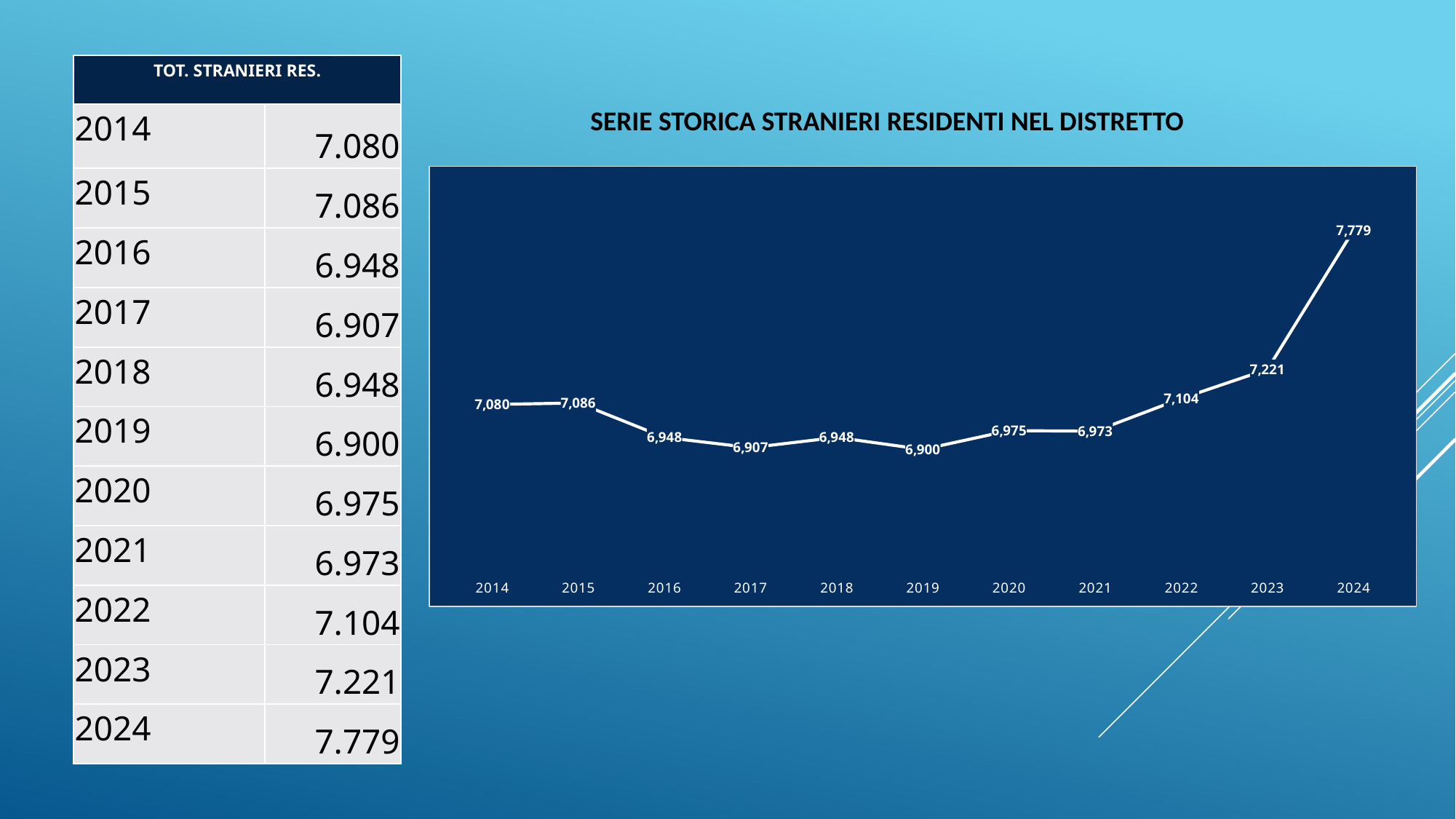
What type of chart is shown on the slide? line chart Which year has the highest value in the chart? 2024 What is the title of the chart? SERIE STORICA STRANIERI RESIDENTI NEL DISTRETTO What is the value for 2014 in the chart? 7,080 Which year has the lowest value in the chart? 2019 Do the values rise or fall from 2021 to 2024? rise What is the value for 2022 in the chart? 7,104 How many years are plotted on the x axis of the chart? 11 What is the difference between the values for 2014 and 2019? 180 What is the difference between the values for 2024 and 2023? 558 Which is larger, the value for 2017 or the value for 2020? 2020 What is the value for 2019 in the chart? 6,900